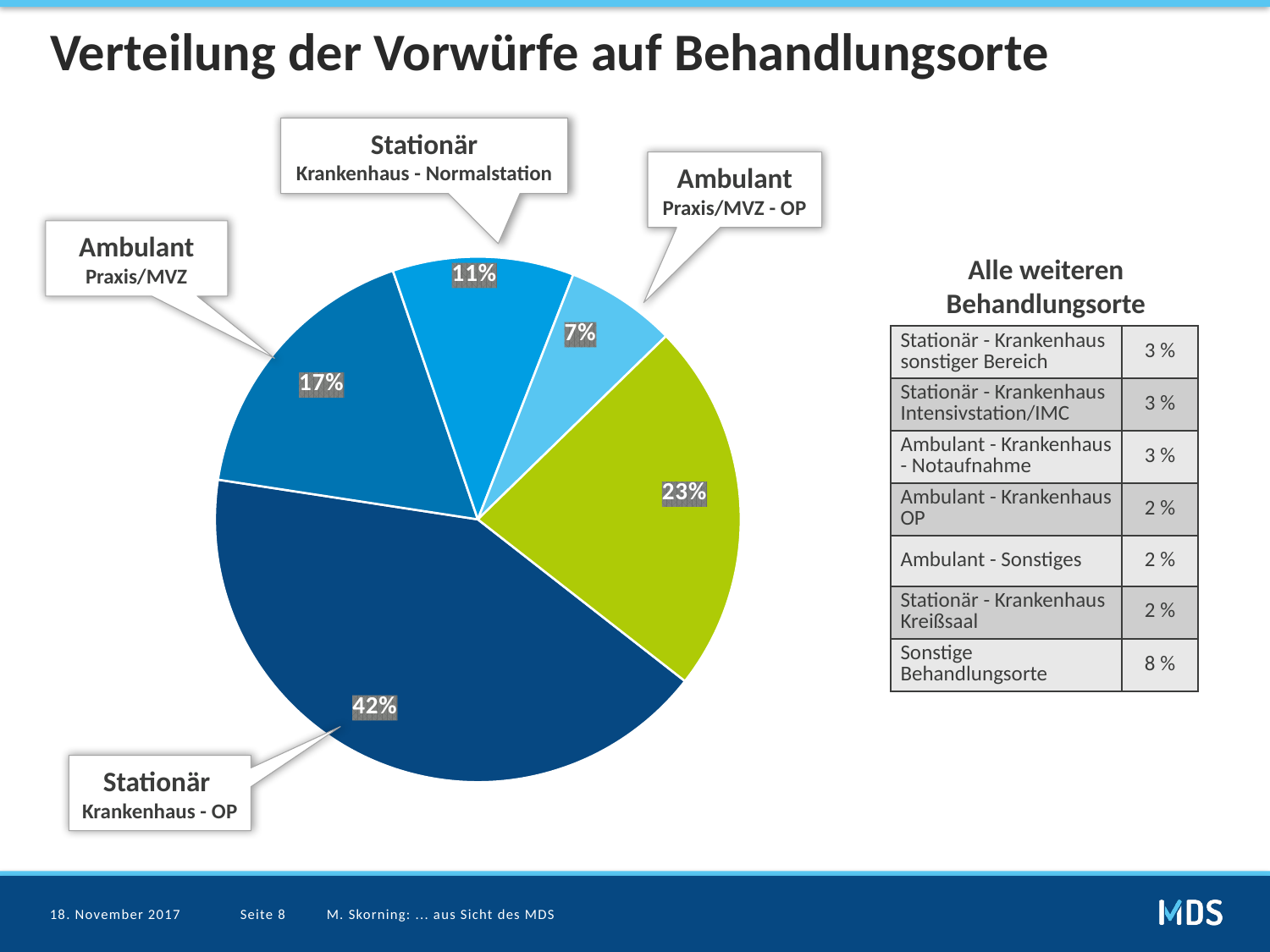
What percentage is shown for Stationär Krankenhaus - Normalstation? 11% What kind of chart is shown on the slide? pie chart What is the title of the slide containing the pie chart? Verteilung der Vorwürfe auf Behandlungsorte Which of the labelled slices is the smallest? Ambulant Praxis/MVZ - OP How many slices does the pie chart have? 5 What is the difference in percentage points between Stationär Krankenhaus - OP and Ambulant Praxis/MVZ? 25 Which slice of the pie is the largest? Stationär Krankenhaus - OP What percentage is shown for Ambulant Praxis/MVZ? 17% Which is larger, the slice for Ambulant Praxis/MVZ or the slice for Stationär Krankenhaus - Normalstation? Ambulant Praxis/MVZ What percentage is shown on the green slice of the pie? 23% What share of the pie is labelled for Stationär Krankenhaus - OP? 42% What percentage is shown for Ambulant Praxis/MVZ - OP? 7%